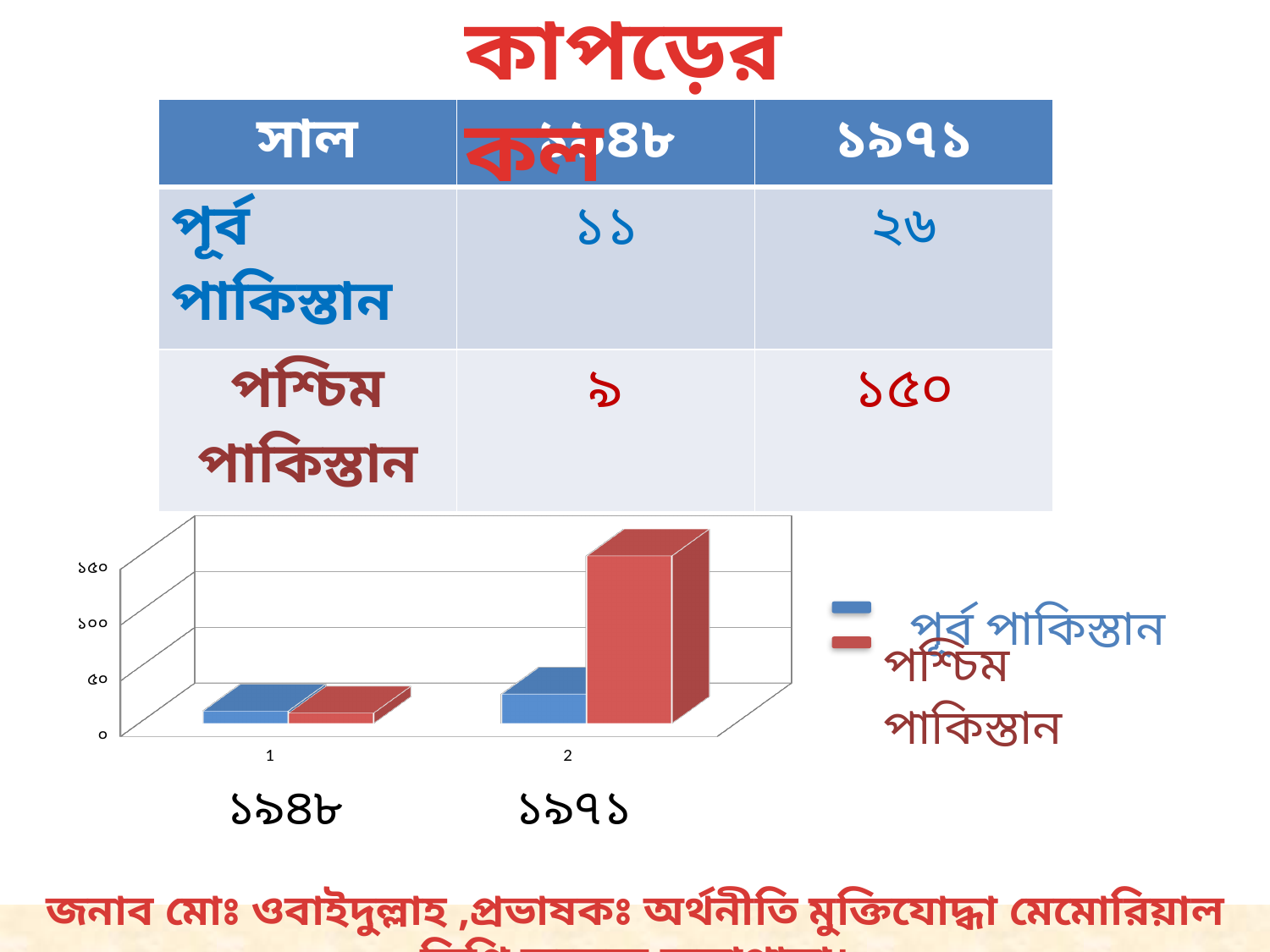
What is the value for পূর্ব পাকিস্তান in ১৯৪৮? ১১ What kind of chart is shown on the slide? bar chart What is the value for পূর্ব পাকিস্তান in ১৯৭১? ২৬ How many series does the chart legend list? 2 Which bar in the chart is the highest? পশ্চিম পাকিস্তান in ১৯৭১ What is the value for পশ্চিম পাকিস্তান in ১৯৭১? ১৫০ How many categories (years) are plotted on the x axis of the chart? 2 What is the difference between the পশ্চিম পাকিস্তান and পূর্ব পাকিস্তান values in ১৯৭১? ১২৪ Which series is shown in red in the chart? পশ্চিম পাকিস্তান Which series is shown in blue in the chart? পূর্ব পাকিস্তান Is the value for পশ্চিম পাকিস্তান in ১৯৭১ greater or less than ১০০? greater Is the value for পূর্ব পাকিস্তান in ১৯৭১ greater or less than ৫০? less